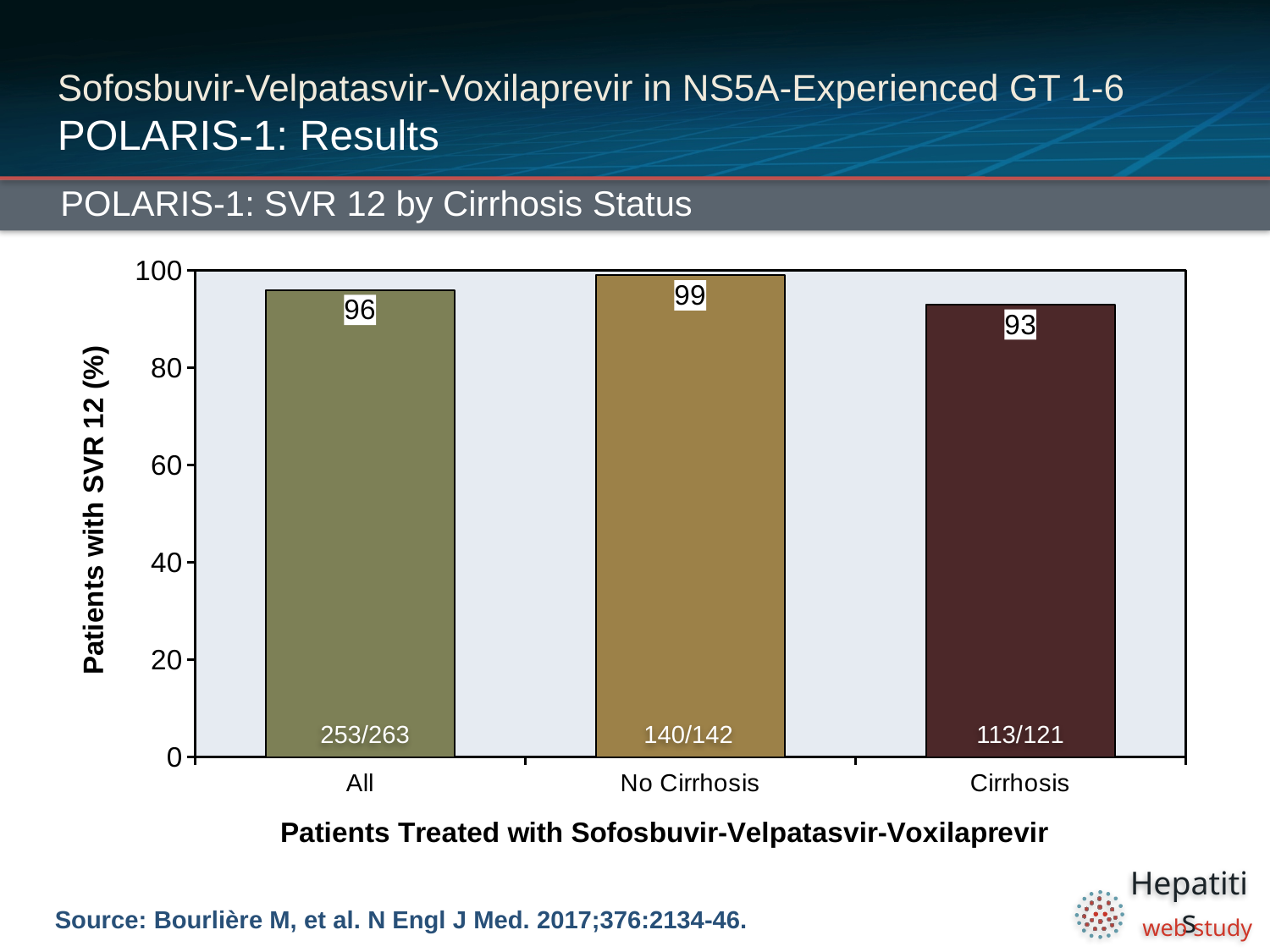
What kind of chart is shown on the slide? Bar chart Which group has the highest SVR 12 rate? No Cirrhosis What is the SVR 12 rate for the All group? 96 How many groups are shown on the x axis? 3 What is the label of the y axis? Patients with SVR 12 (%) What is the SVR 12 rate for patients with No Cirrhosis? 99 Which group has the lowest SVR 12 rate? Cirrhosis What is the difference in SVR 12 rate between the No Cirrhosis and Cirrhosis groups? 6 What is the SVR 12 rate for patients with Cirrhosis? 93 What fraction of patients is shown inside the Cirrhosis bar? 113/121 Which group has a higher SVR 12 rate, All or Cirrhosis? All What fraction of patients is shown inside the No Cirrhosis bar? 140/142